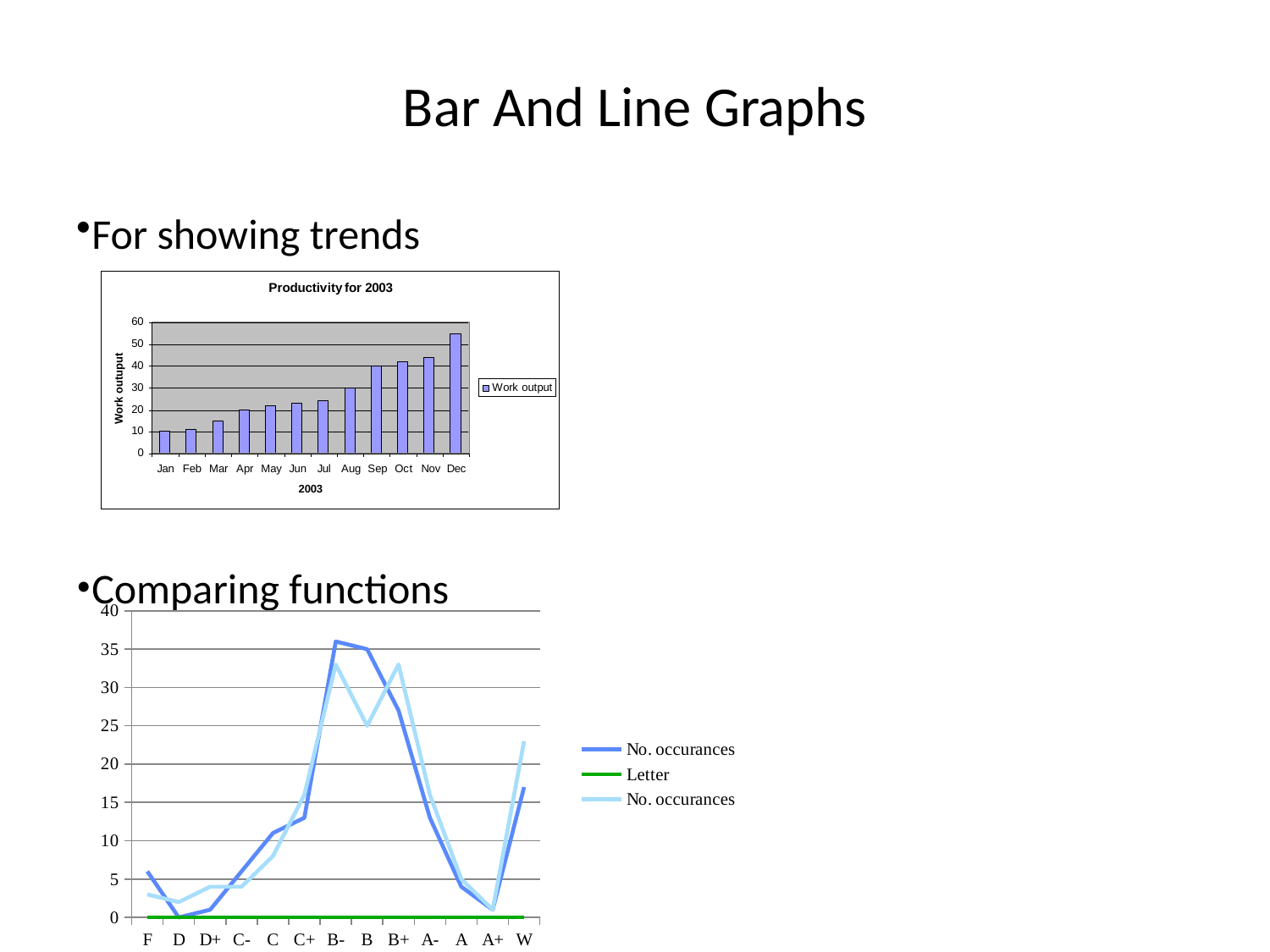
In the 'Productivity for 2003' chart, is the value for Dec greater or less than 50? greater How many months are shown on the x axis of the 'Productivity for 2003' chart? 12 In the 'Productivity for 2003' chart, do the values rise or fall from Jan to Dec? rise How many series does the legend of the 'Productivity for 2003' chart list? 1 How many categories are shown on the x axis of the bottom chart? 13 How many series does the legend of the bottom chart list? 3 In the 'Productivity for 2003' chart, which month has the highest work output? Dec In the 'Productivity for 2003' chart, is the value for Jan greater or less than 20? less In the 'Productivity for 2003' chart, is the value for Sep greater or less than 30? greater What type of chart is the 'Productivity for 2003' chart? bar chart In the bottom chart, at category B, which series is larger: the dark blue 'No. occurances' line or the light blue 'No. occurances' line? the dark blue 'No. occurances' line What type of chart is the bottom chart on the slide? line chart